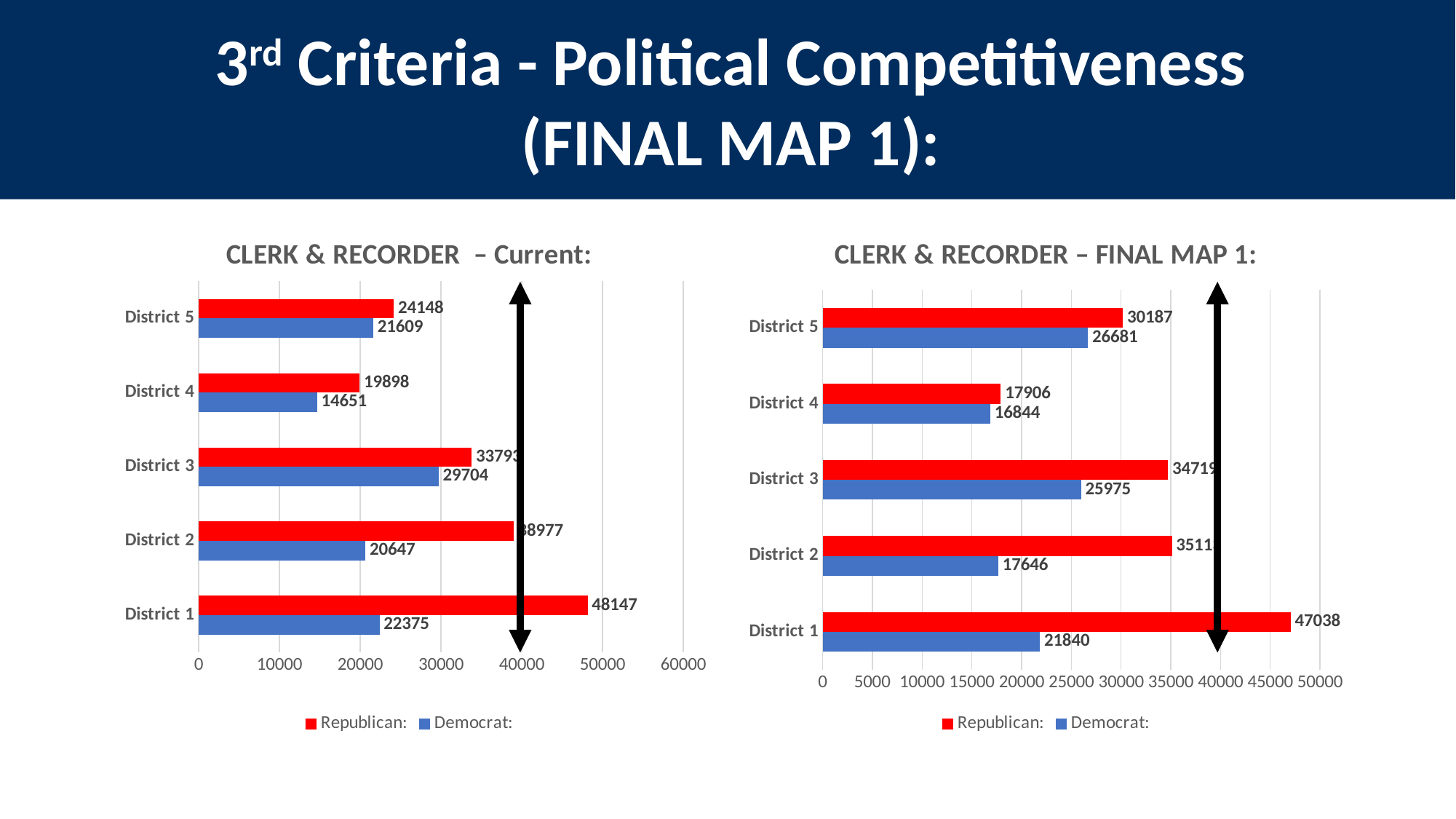
In the CLERK & RECORDER – Current chart, what is the difference between the Republican and Democrat values for District 5? 2539 In the CLERK & RECORDER – Current chart, what is the Democrat value for District 4? 14651 In the CLERK & RECORDER – FINAL MAP 1 chart, which is larger for District 1, the Republican value or the Democrat value? Republican In the CLERK & RECORDER – Current chart, is the Democrat value for District 3 greater or less than 20000? greater What type of chart is the CLERK & RECORDER – Current chart? Bar chart How many districts are shown in the CLERK & RECORDER – FINAL MAP 1 chart? 5 In the CLERK & RECORDER – Current chart, what is the Republican value for District 1? 48147 In the CLERK & RECORDER – FINAL MAP 1 chart, what is the difference between the Republican and Democrat values for District 4? 1062 In the CLERK & RECORDER – FINAL MAP 1 chart, what is the Republican value for District 5? 30187 In the CLERK & RECORDER – FINAL MAP 1 chart, what is the Democrat value for District 2? 17646 In the CLERK & RECORDER – FINAL MAP 1 chart, which district has the lowest Democrat value? District 4 In the CLERK & RECORDER – Current chart, which district has the highest Republican value? District 1